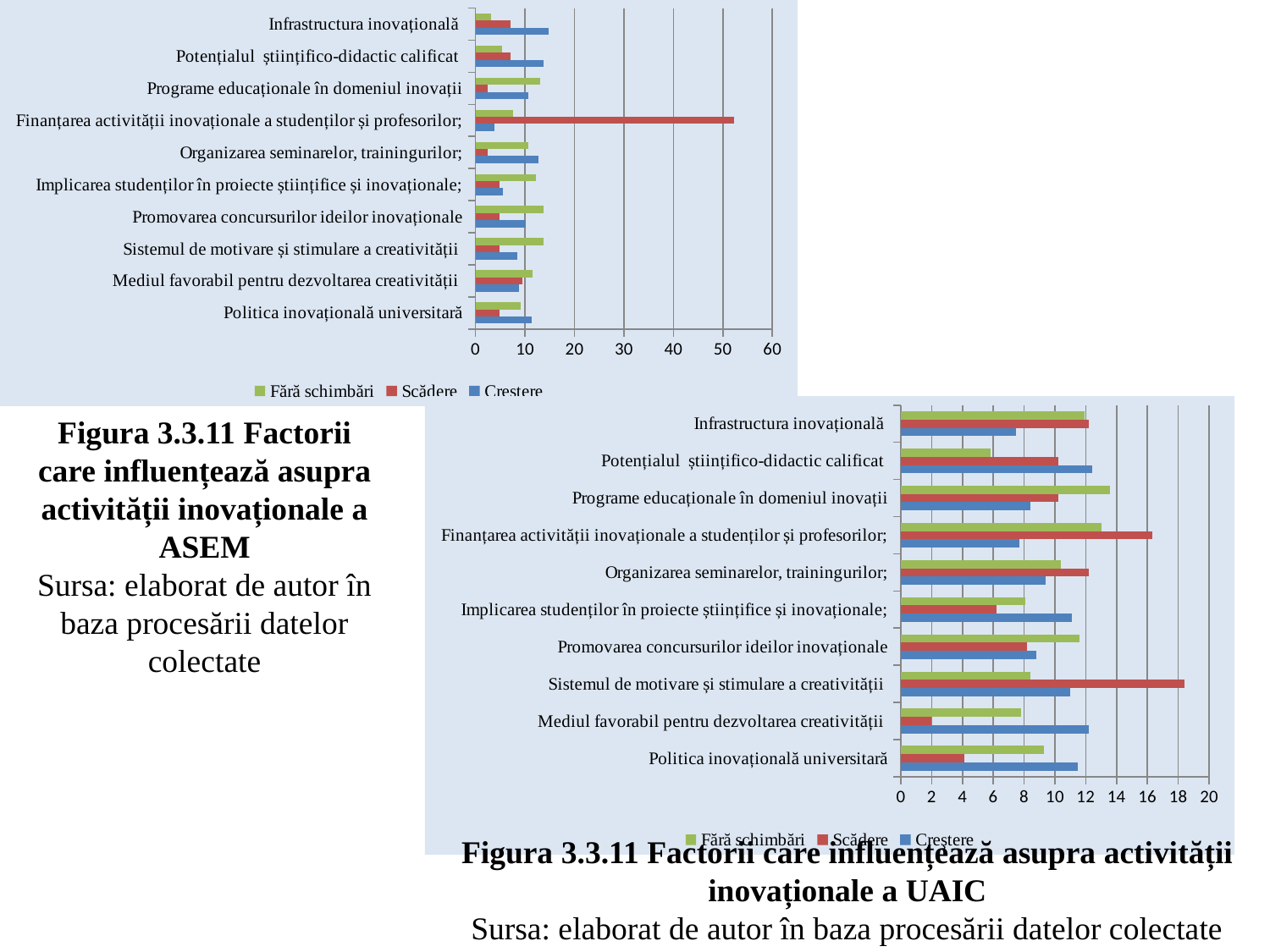
In the bottom chart (UAIC), is the Scădere value for Mediul favorabil pentru dezvoltarea creativității greater or less than 4? less How many series does the legend of the bottom chart (Figura 3.3.11 ... UAIC) list? 3 What type of chart is the top chart (Figura 3.3.11 ... ASEM)? bar chart What are the three legend entries of the top chart (ASEM)? Fără schimbări, Scădere, Creștere In the top chart (ASEM), is the Scădere value for Finanțarea activității inovaționale a studenților și profesorilor greater or less than 40? greater In the bottom chart (UAIC), which is larger for Finanțarea activității inovaționale a studenților și profesorilor: the Scădere value or the Creștere value? Scădere In the bottom chart (UAIC), which category has the shortest Scădere bar? Mediul favorabil pentru dezvoltarea creativității In the bottom chart (UAIC), which category has the longest Scădere bar? Sistemul de motivare și stimulare a creativității In the top chart (ASEM), which category has the longest Scădere bar? Finanțarea activității inovaționale a studenților și profesorilor In the bottom chart (UAIC), is the Scădere value for Sistemul de motivare și stimulare a creativității greater or less than 16? greater How many categories are shown on the top chart (ASEM)? 10 In the top chart (ASEM), which is larger for Infrastructura inovațională: the Creștere value or the Scădere value? Creștere